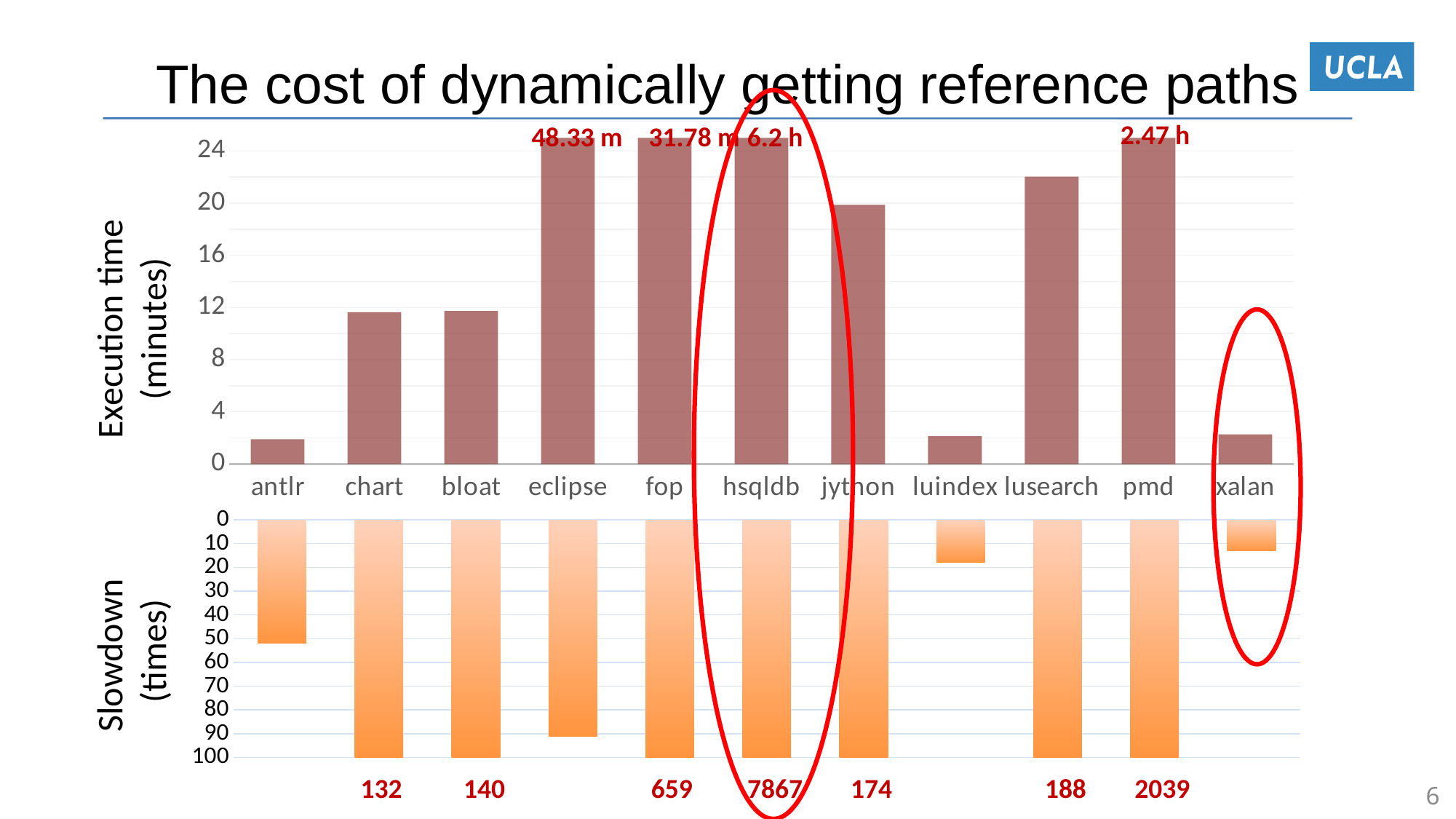
In the bottom chart (Slowdown), is the value for eclipse greater or less than 80? greater In the bottom chart (Slowdown), what is the slowdown value printed for hsqldb? 7867 In the top chart (Execution time), is the value for lusearch greater or less than 20? greater How many benchmarks are shown on the x axis of the top chart? 11 In the top chart (Execution time), what is the execution time printed for hsqldb? 6.2 h In the bottom chart (Slowdown), what is the difference between the slowdown for pmd and the slowdown for lusearch? 1851 In the top chart (Execution time), what is the execution time printed for pmd? 2.47 h In the top chart (Execution time), which has the larger execution time, eclipse or fop? eclipse In the bottom chart (Slowdown), which benchmark has the highest slowdown? hsqldb In the bottom chart (Slowdown), what is the slowdown value printed for fop? 659 What kind of chart is the top chart (Execution time)? bar chart In the top chart (Execution time), what is the execution time printed for eclipse? 48.33 m